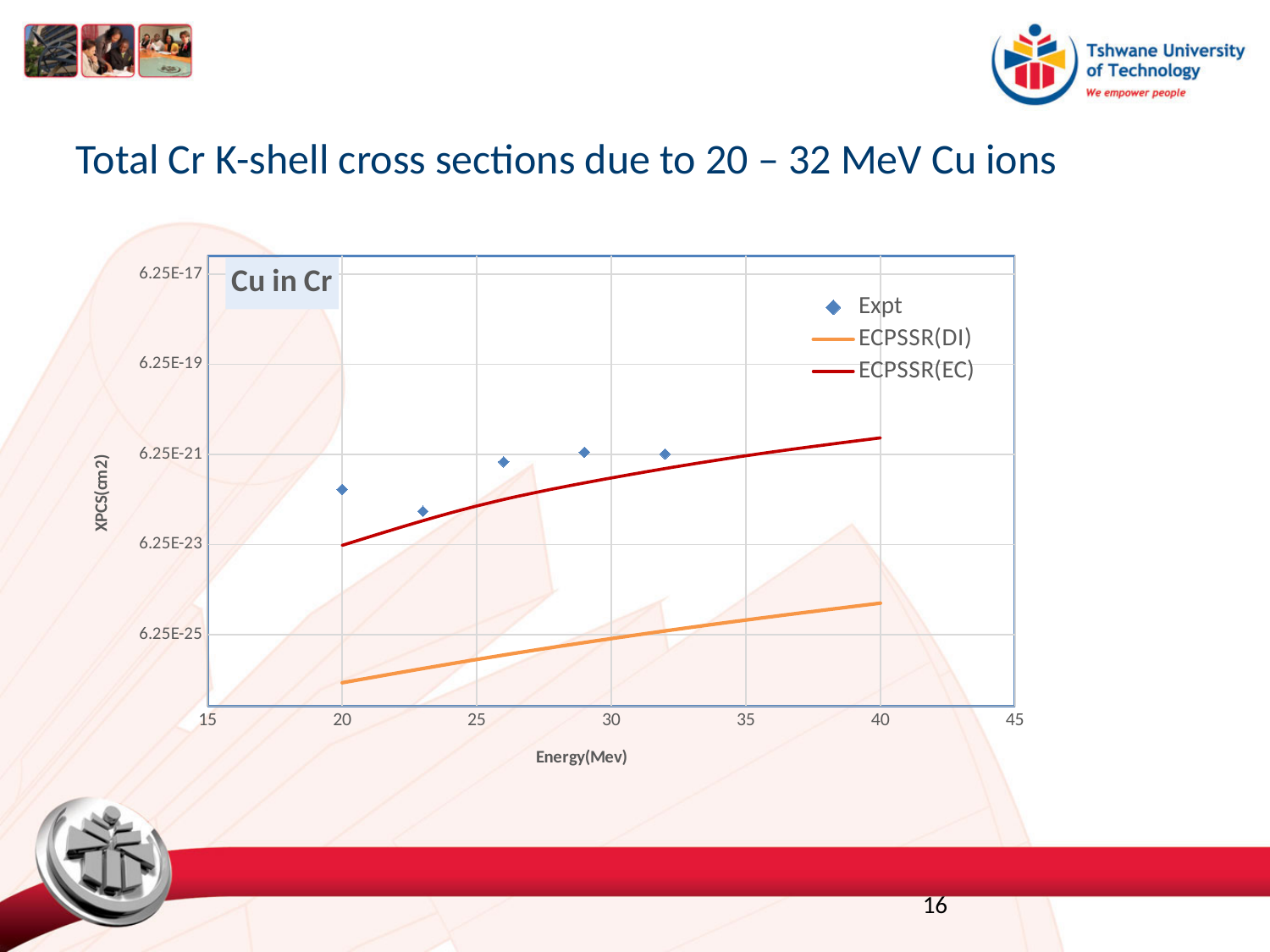
What are the names of the series listed in the legend? Expt, ECPSSR(DI), ECPSSR(EC) Which Expt point has the lowest value? 23 MeV Is the ECPSSR(EC) value at 40 MeV greater or less than 6.25E-21? greater How many Expt data points are plotted? 5 What is the label on the x axis? Energy(Mev) What kind of chart is shown? Scatter chart with lines At 30 MeV, which is larger: ECPSSR(EC) or ECPSSR(DI)? ECPSSR(EC) Does the ECPSSR(EC) line rise or fall as energy increases? Rises How many series does the legend list? 3 Does the ECPSSR(DI) line rise or fall as energy increases? Rises Is the ECPSSR(DI) value at 40 MeV greater or less than 6.25E-23? less Is the Expt value at 20 MeV greater or less than 6.25E-21? less